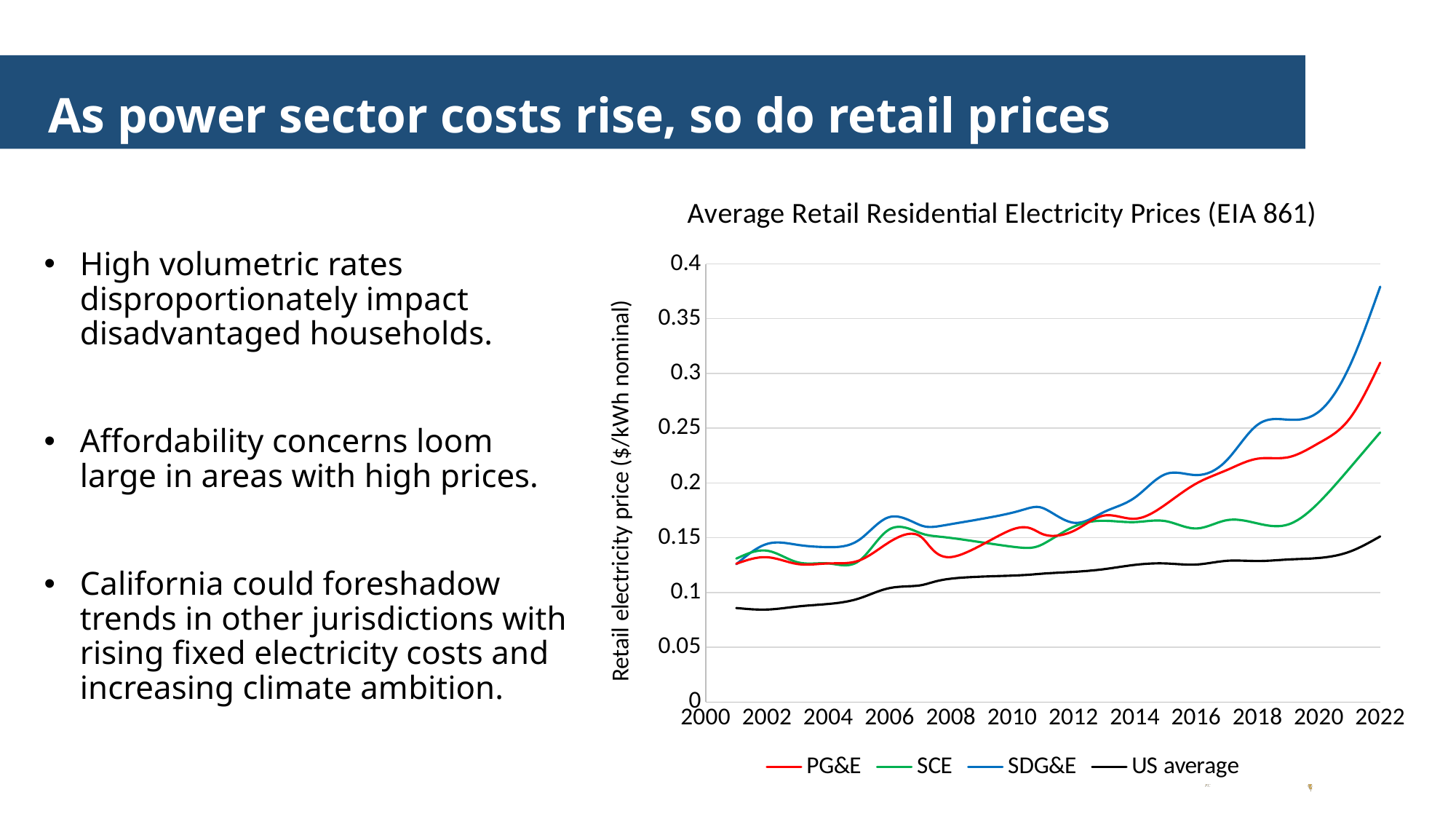
Is the value for US average in 2001 greater or less than 0.1? less Which series has the highest value in 2022? SDG&E Is the value for US average in 2022 greater or less than 0.2? less How many series does the legend list? 4 Which series has the lowest value in 2022? US average Does the US average series generally rise or fall from 2001 to 2022? rise Is the value for PG&E in 2022 greater or less than 0.25? greater Which is larger in 2022, the value for SDG&E or the value for PG&E? SDG&E What is the title of the chart? Average Retail Residential Electricity Prices (EIA 861) What kind of chart is shown on the slide? Line chart Which series is drawn in blue? SDG&E